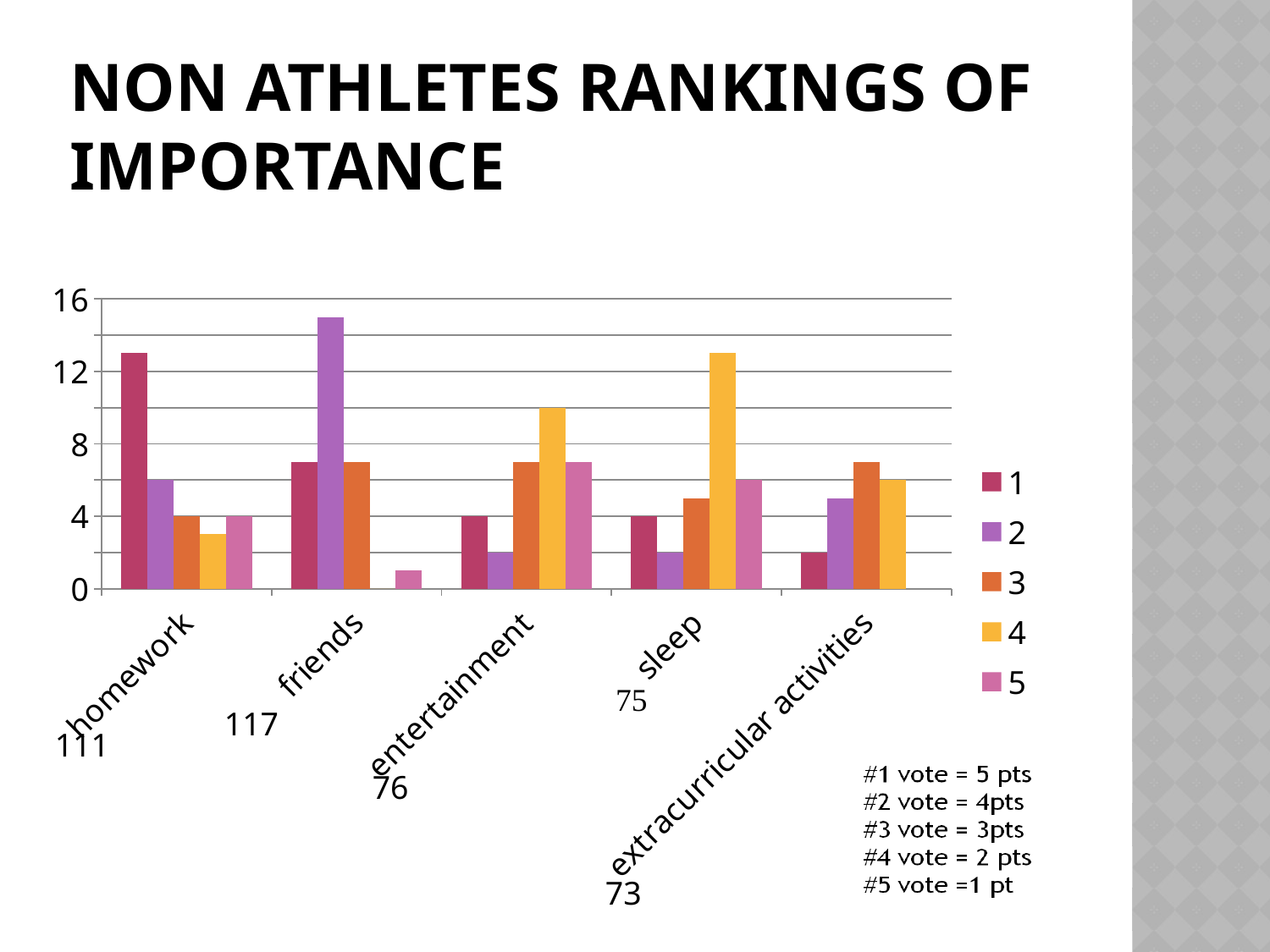
Is the value of series 2 for friends greater or less than 12? greater Is the value of series 4 for entertainment greater or less than 8? greater Which category has the tallest bar for series 2? friends Is the value of series 4 for sleep greater or less than 12? greater What kind of chart is shown on the slide? bar chart What is the value of series 3 for homework? 4 What is the value of series 1 for sleep? 4 What number is printed below the friends category label? 117 Which series has the highest value for sleep? 4 For homework, which is larger: series 1 or series 2? series 1 How many categories are shown on the x axis of the chart? 5 How many series does the chart legend list? 5